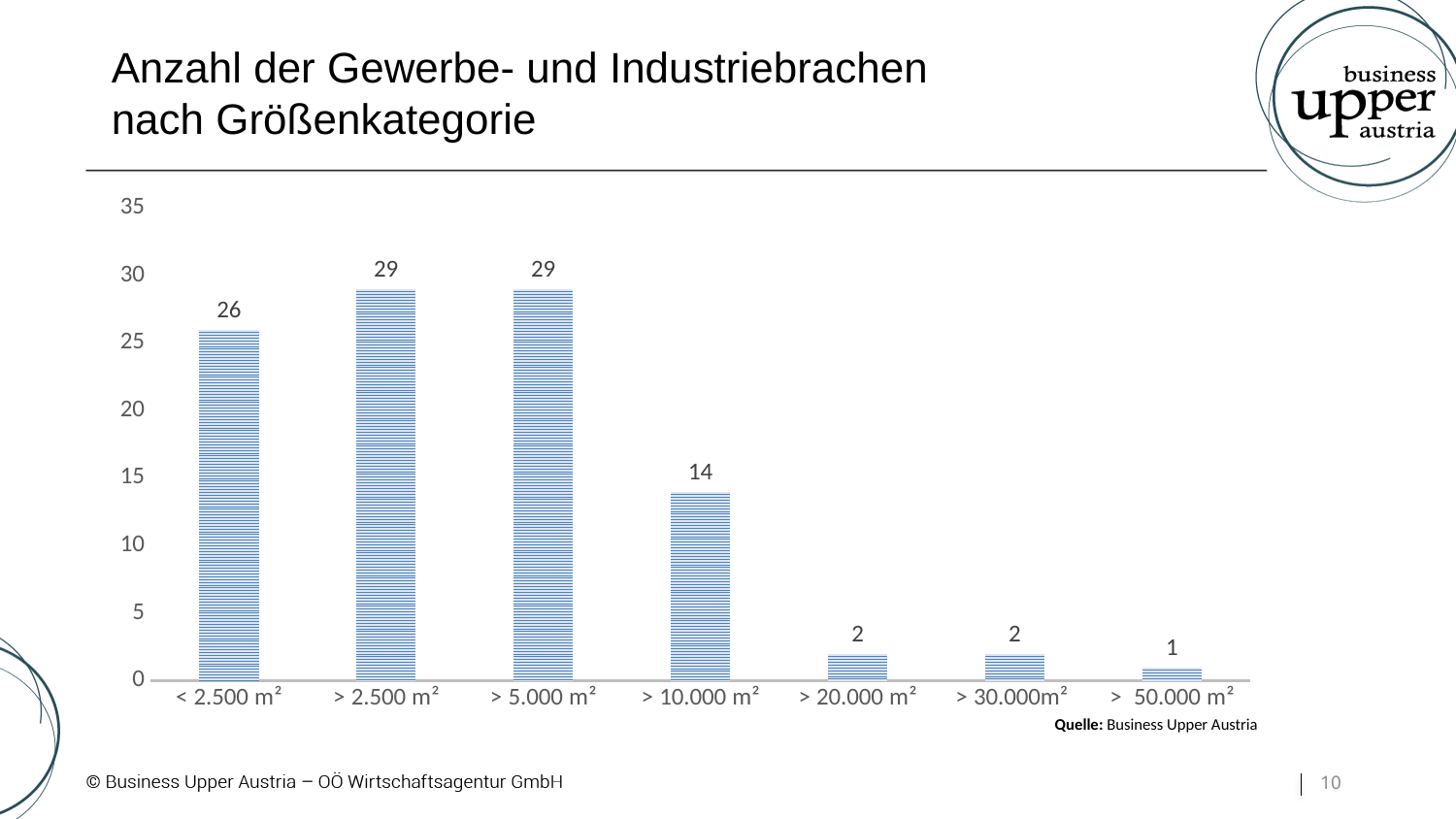
How many categories are shown on the x axis? 7 What kind of chart is shown on the slide? bar chart What is the difference between the values for "> 2.500 m²" and "> 10.000 m²"? 15 Which is larger, the value for "< 2.500 m²" or the value for "> 5.000 m²"? > 5.000 m² What is the difference between the values for "< 2.500 m²" and "> 20.000 m²"? 24 Do the values rise or fall from "> 5.000 m²" to "> 50.000 m²" along the x axis? fall What is the value for the category "> 50.000 m²"? 1 What is the value for the category "> 10.000 m²"? 14 What is the value for the category "< 2.500 m²"? 26 Which category has the lowest value? > 50.000 m² What is the title of the slide containing the chart? Anzahl der Gewerbe- und Industriebrachen nach Größenkategorie Is the value for "> 10.000 m²" greater or less than 15? less